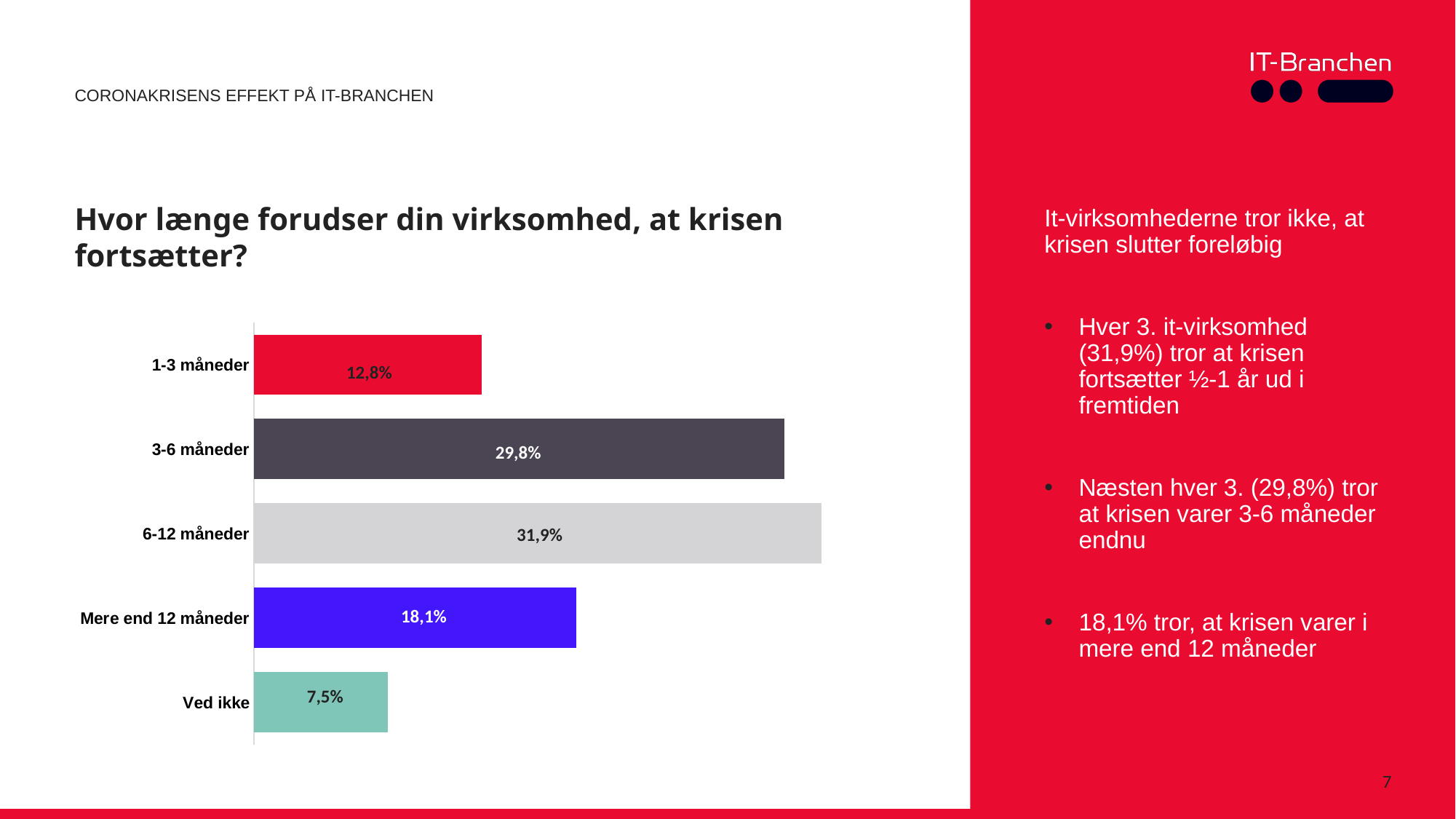
How many categories are shown in the chart? 5 What is the value for "Ved ikke"? 7,5% Which category has the highest value? 6-12 måneder What is the value for "6-12 måneder"? 31,9% What is the title of the chart? Hvor længe forudser din virksomhed, at krisen fortsætter? What is the value for "Mere end 12 måneder"? 18,1% What colour is the bar for "1-3 måneder"? Red What is the difference between the values for "3-6 måneder" and "1-3 måneder"? 17,0% What is the value for "1-3 måneder"? 12,8% Which is larger, the value for "Mere end 12 måneder" or the value for "1-3 måneder"? Mere end 12 måneder What kind of chart is shown on the slide? Bar chart Which category has the lowest value? Ved ikke